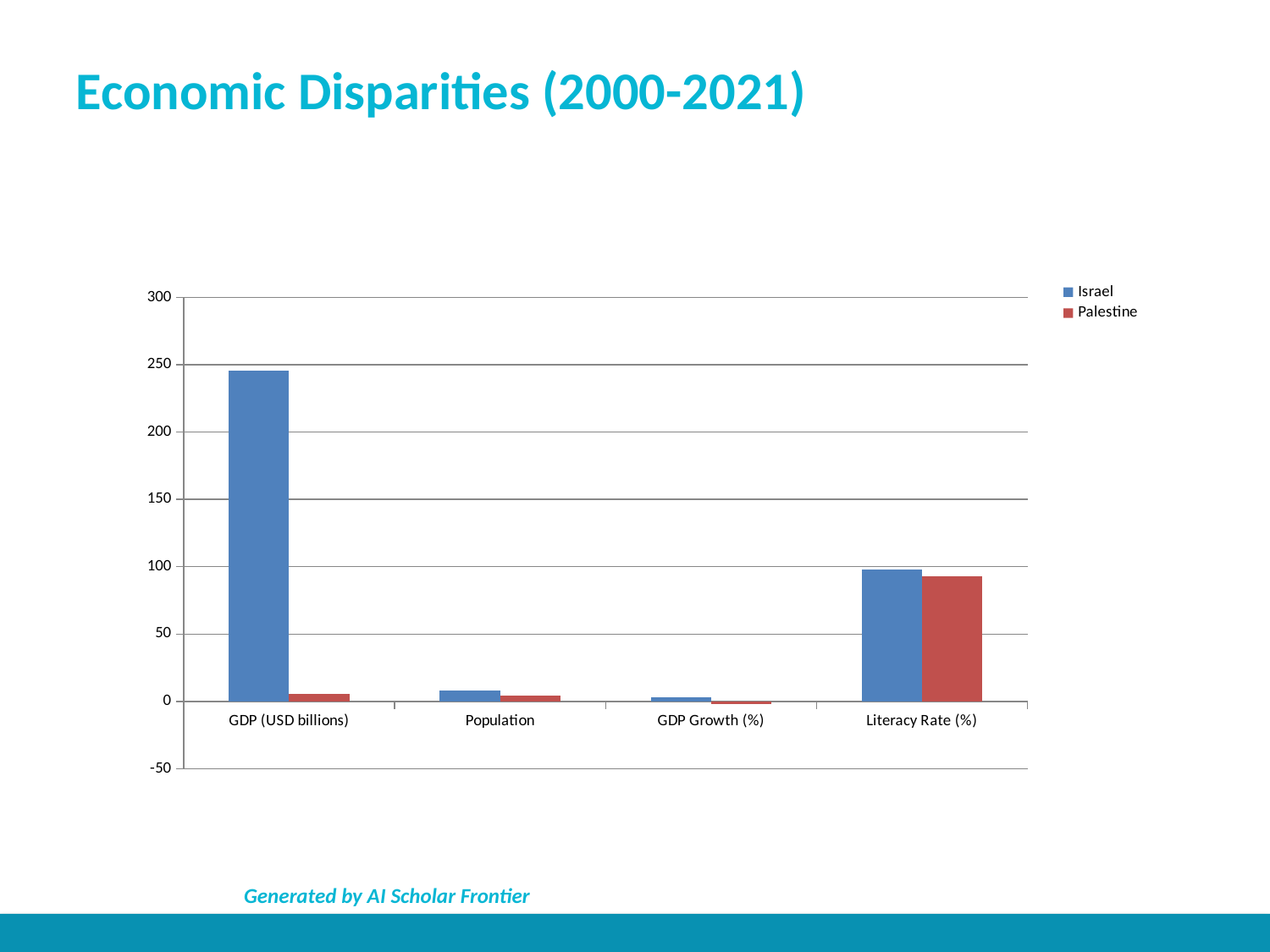
Is the value for Israel in GDP (USD billions) greater or less than 200? greater Which category has the highest value for Israel? GDP (USD billions) Which colour represents Palestine in the chart? red How many series does the legend list? 2 What kind of chart is shown on the slide? bar chart Which category has the highest value for Palestine? Literacy Rate (%) Which is larger in GDP (USD billions), Israel or Palestine? Israel Is the value for Palestine in GDP (USD billions) greater or less than 50? less What is the title of the slide? Economic Disparities (2000-2021) How many categories are shown on the x axis? 4 Is the value for Palestine in Literacy Rate (%) greater or less than 50? greater